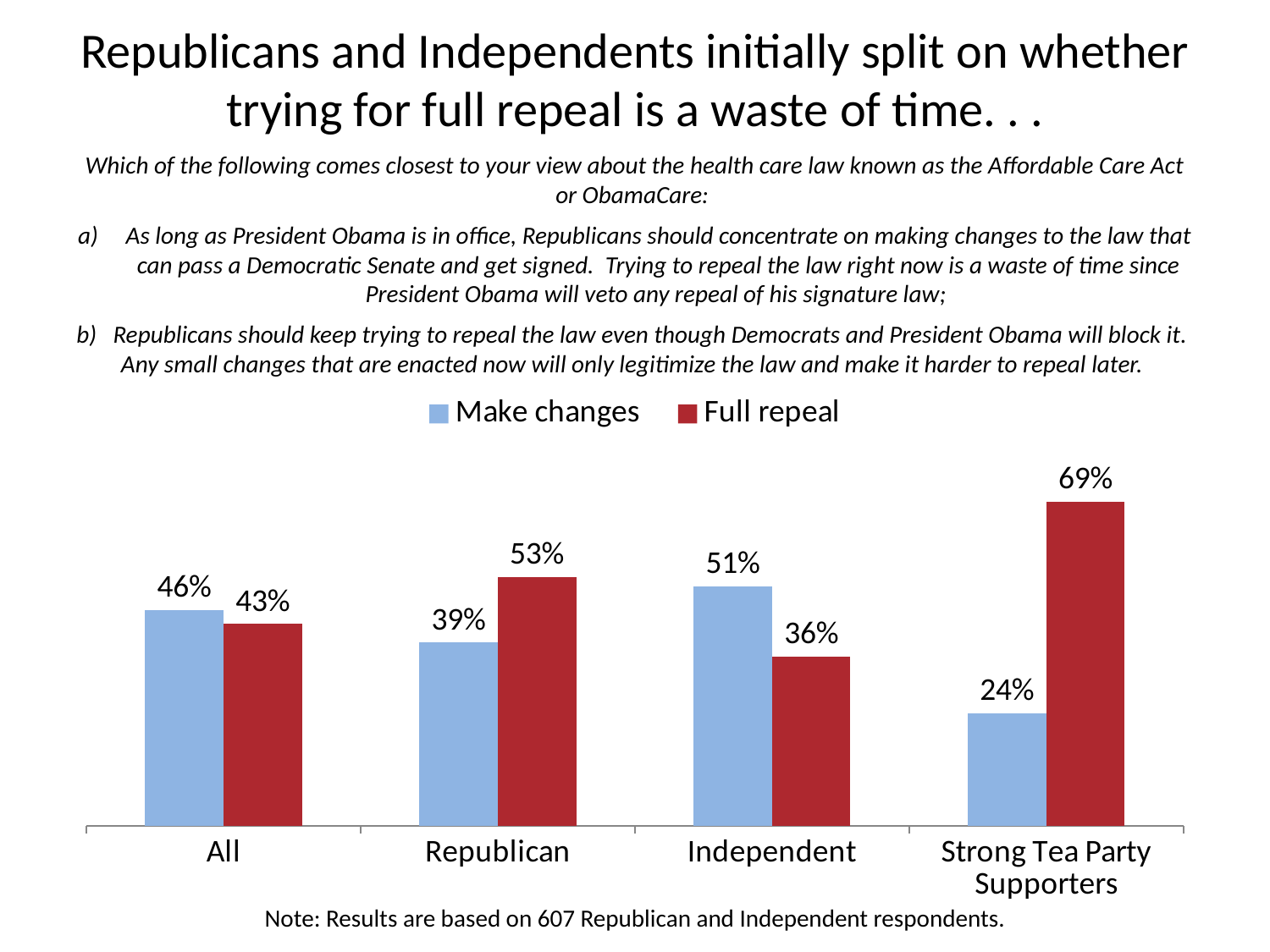
Which colour represents the Full repeal series? Red What is the value for Full repeal in the All category? 43% What kind of chart is shown on the slide? Bar chart What is the difference between Full repeal and Make changes among Strong Tea Party Supporters? 45% What is the value for Make changes among Republicans? 39% What is the value for Make changes among Independents? 51% How many categories are shown on the x axis? 4 How many series does the legend list? 2 Among Republicans, which is larger: Make changes or Full repeal? Full repeal Which category has the lowest Make changes value? Strong Tea Party Supporters What is the value for Full repeal among Strong Tea Party Supporters? 69% Which category has the highest Full repeal value? Strong Tea Party Supporters